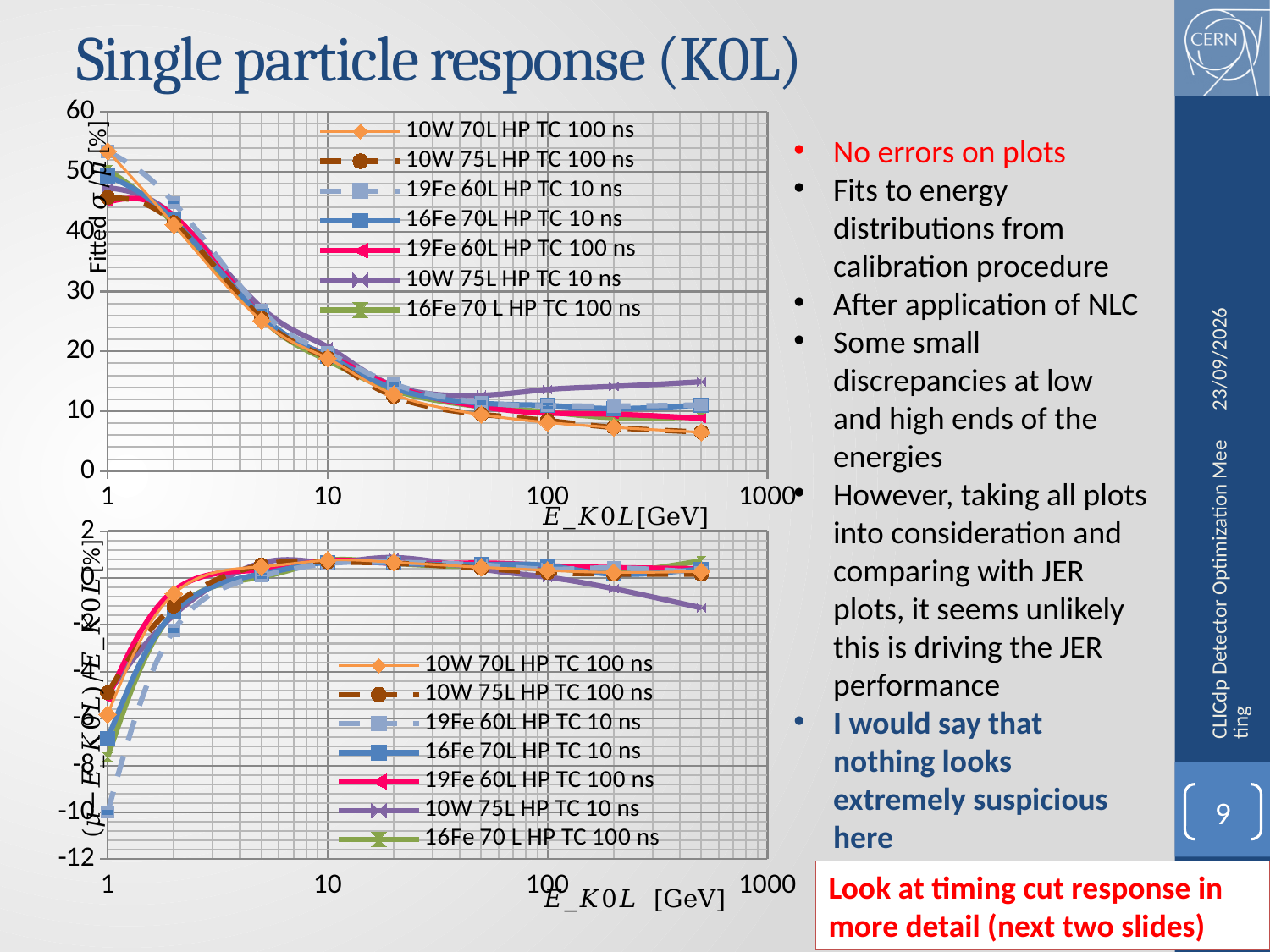
In the top chart, is the value for 10W 75L HP TC 10 ns at its highest plotted energy greater or less than 10? greater In the top chart, do the values generally rise or fall as E_K0L increases from 1 to 1000 GeV? fall In the top chart, is the value for 10W 70L HP TC 100 ns at 1 GeV greater or less than 40? greater In the bottom chart, do the values rise or fall as E_K0L increases from 1 to 10 GeV? rise How many series does the legend of the top chart list? 7 What is the first legend entry of the bottom chart? 10W 70L HP TC 100 ns How many series does the legend of the bottom chart list? 7 In the bottom chart, is the value for 19Fe 60L HP TC 10 ns at 1 GeV greater or less than -4? less What kind of chart is the top chart on the slide? line chart What is the x-axis label of the top chart? E_K0L [GeV]